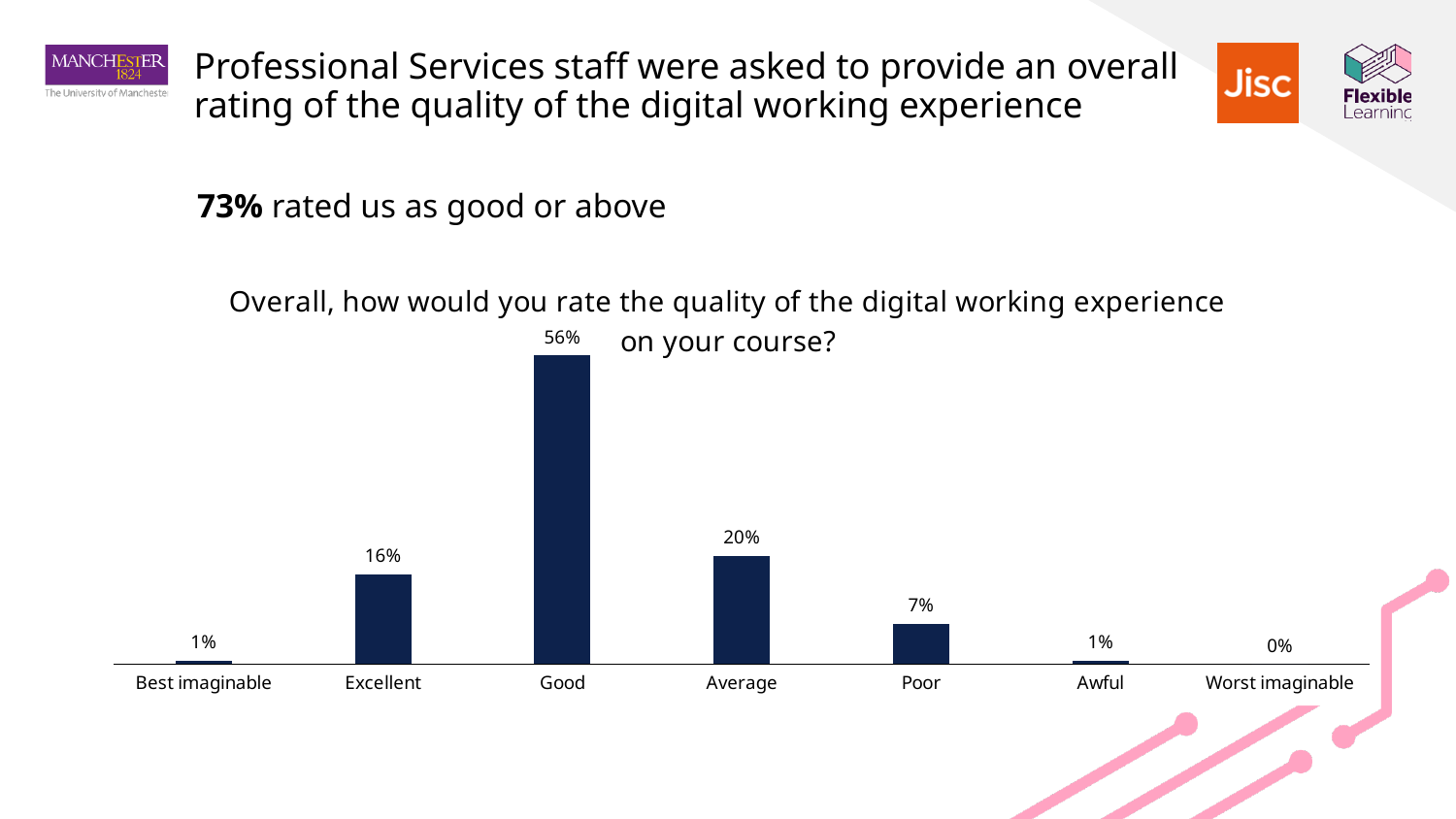
How many rating categories are shown on the x axis? 7 What percentage of respondents rated the digital working experience as Good? 56% What percentage of respondents rated the digital working experience as Excellent? 16% What percentage of respondents rated the digital working experience as Worst imaginable? 0% What percentage of respondents rated the digital working experience as Average? 20% Which rating category has the lowest percentage? Worst imaginable Which has a larger percentage, Excellent or Average? Average What is the difference in percentage points between the Good and Average ratings? 36 What is the title of the chart? Overall, how would you rate the quality of the digital working experience on your course? What percentage of respondents rated the digital working experience as Poor? 7% Which rating category has the highest percentage? Good What type of chart is shown on the slide? Bar chart